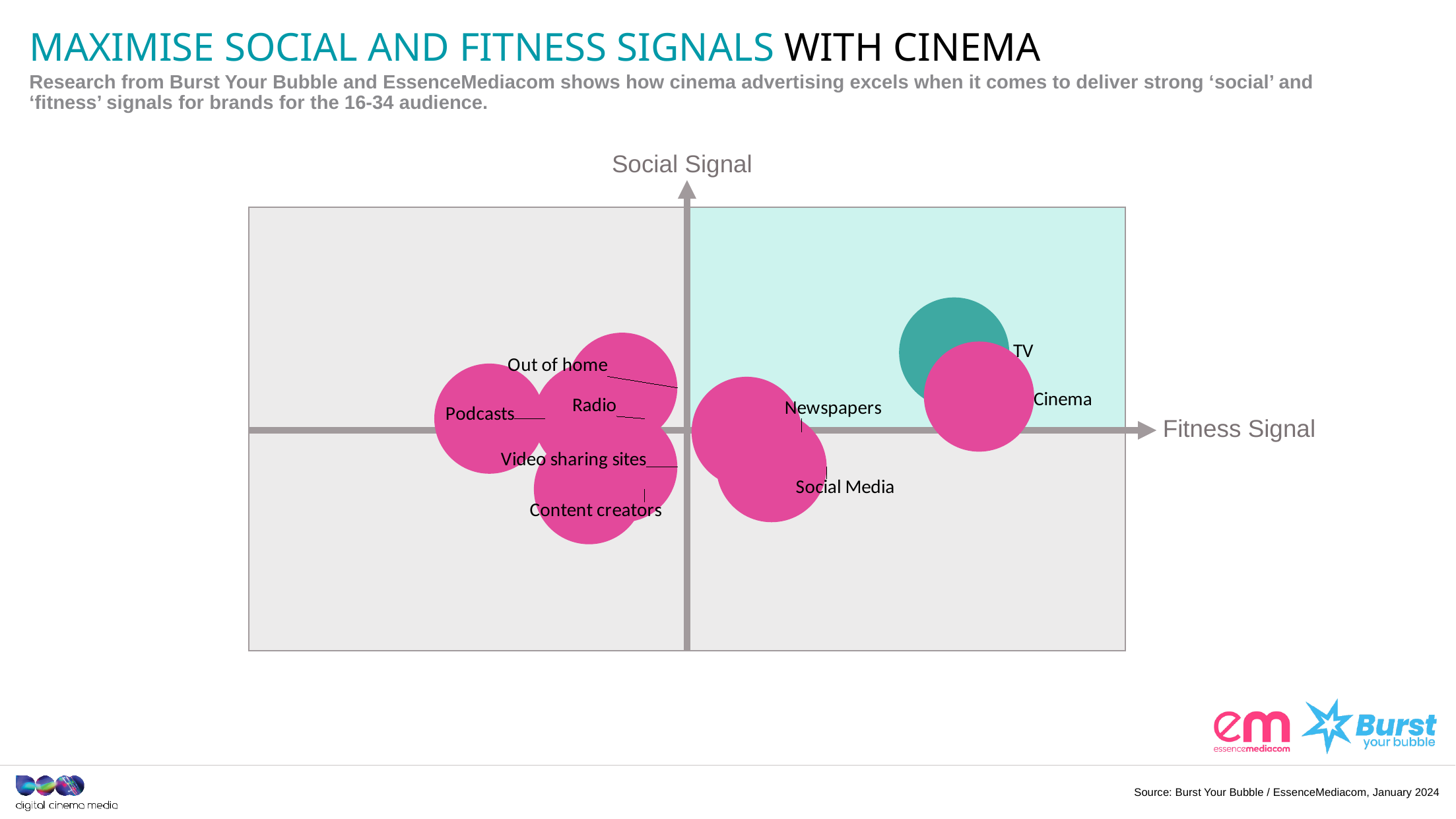
What does the horizontal axis of the chart represent? Fitness Signal Which media channel has the highest Social Signal on the chart? TV Which has the higher Social Signal, Out of home or Content creators? Out of home Which media channel has the lowest Social Signal on the chart? Content creators What kind of chart is shown on the slide? Bubble chart (scatter plot) Which has the higher Fitness Signal, Cinema or Podcasts? Cinema Which media channel has the lowest Fitness Signal on the chart? Podcasts What does the vertical axis of the chart represent? Social Signal Which media channel has the highest Fitness Signal on the chart? Cinema Which has the higher Social Signal, TV or Social Media? TV How many media channels are plotted on the chart? 9